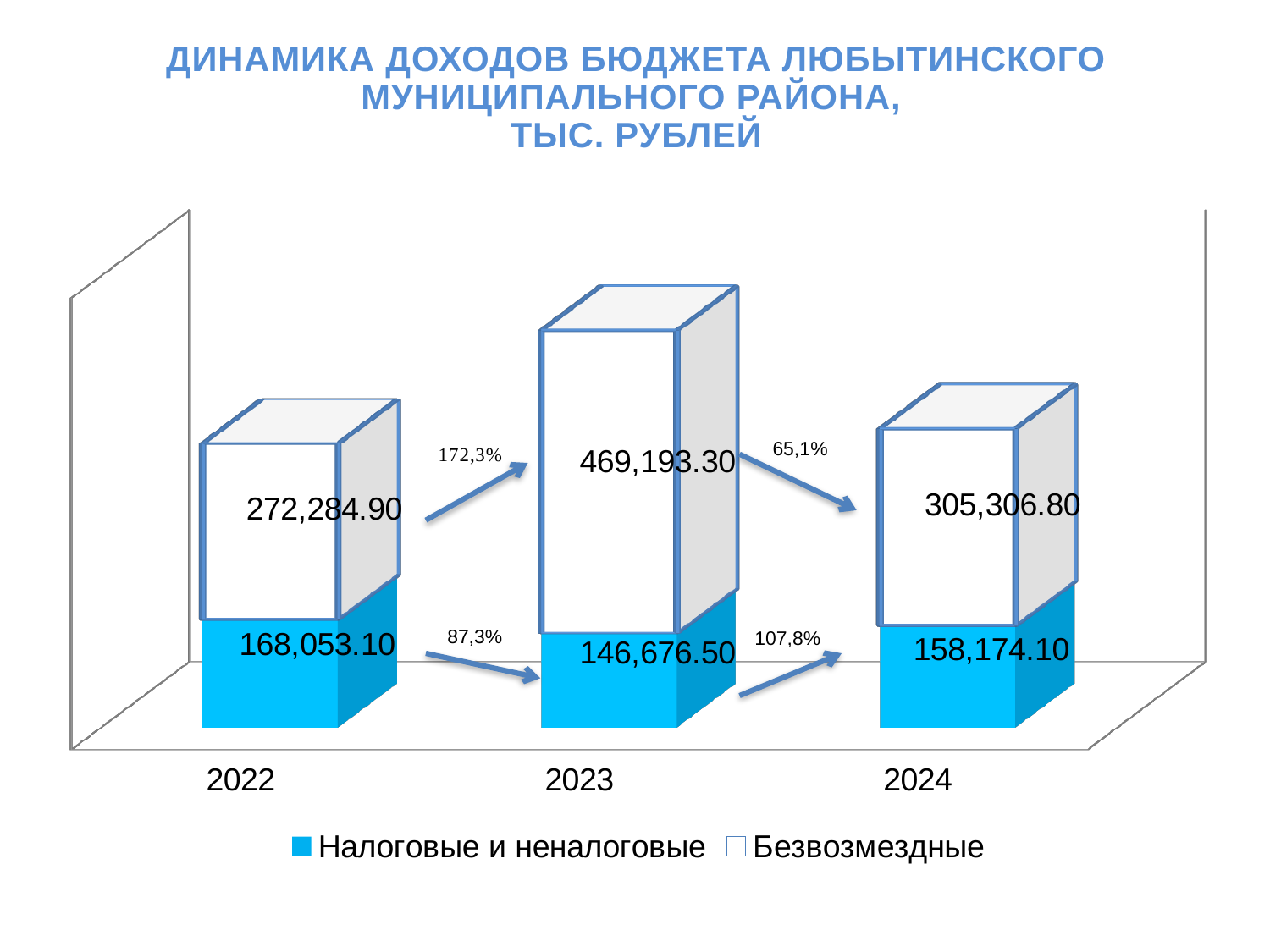
What is the value of Налоговые и неналоговые for 2022? 168,053.10 How many series does the legend list? 2 What is the value of Безвозмездные for 2023? 469,193.30 Which is larger: Налоговые и неналоговые in 2024 or in 2023? 2024 What is the value of Безвозмездные for 2024? 305,306.80 In which year is the Налоговые и неналоговые value lowest? 2023 What is the total of the stacked bar for 2022? 440,338.00 What type of chart is shown on the slide? Stacked bar chart How many years (categories) are shown on the x axis? 3 In which year is the Безвозмездные value highest? 2023 What is the difference between the Безвозмездные values for 2023 and 2022? 196,908.40 What percentage is shown on the arrow between the Безвозмездные values for 2022 and 2023? 172,3%